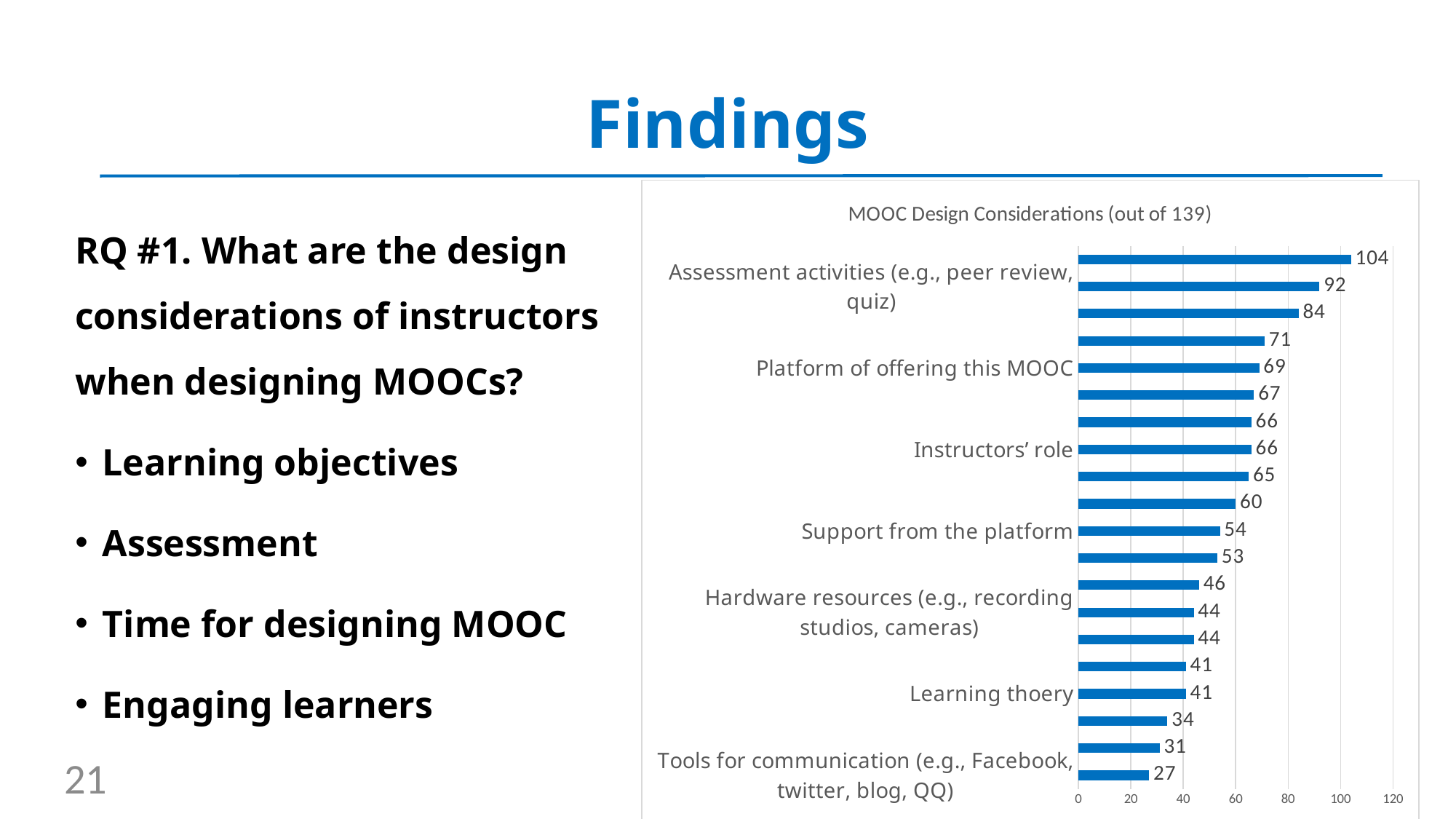
What kind of chart is shown on the slide? bar chart How many bars are plotted on the chart? 20 What is the value for Platform of offering this MOOC? 69 What is the value for Assessment activities (e.g., peer review, quiz)? 92 Which labeled category has the lowest value? Tools for communication (e.g., Facebook, twitter, blog, QQ) What is the title of the chart? MOOC Design Considerations (out of 139) What is the value for Support from the platform? 54 What is the value for Tools for communication (e.g., Facebook, twitter, blog, QQ)? 27 What is the highest value shown on the chart? 104 What is the difference between the values for Assessment activities and Tools for communication? 65 Which is larger, the value for Platform of offering this MOOC or the value for Support from the platform? Platform of offering this MOOC What is the value for Instructors' role? 66